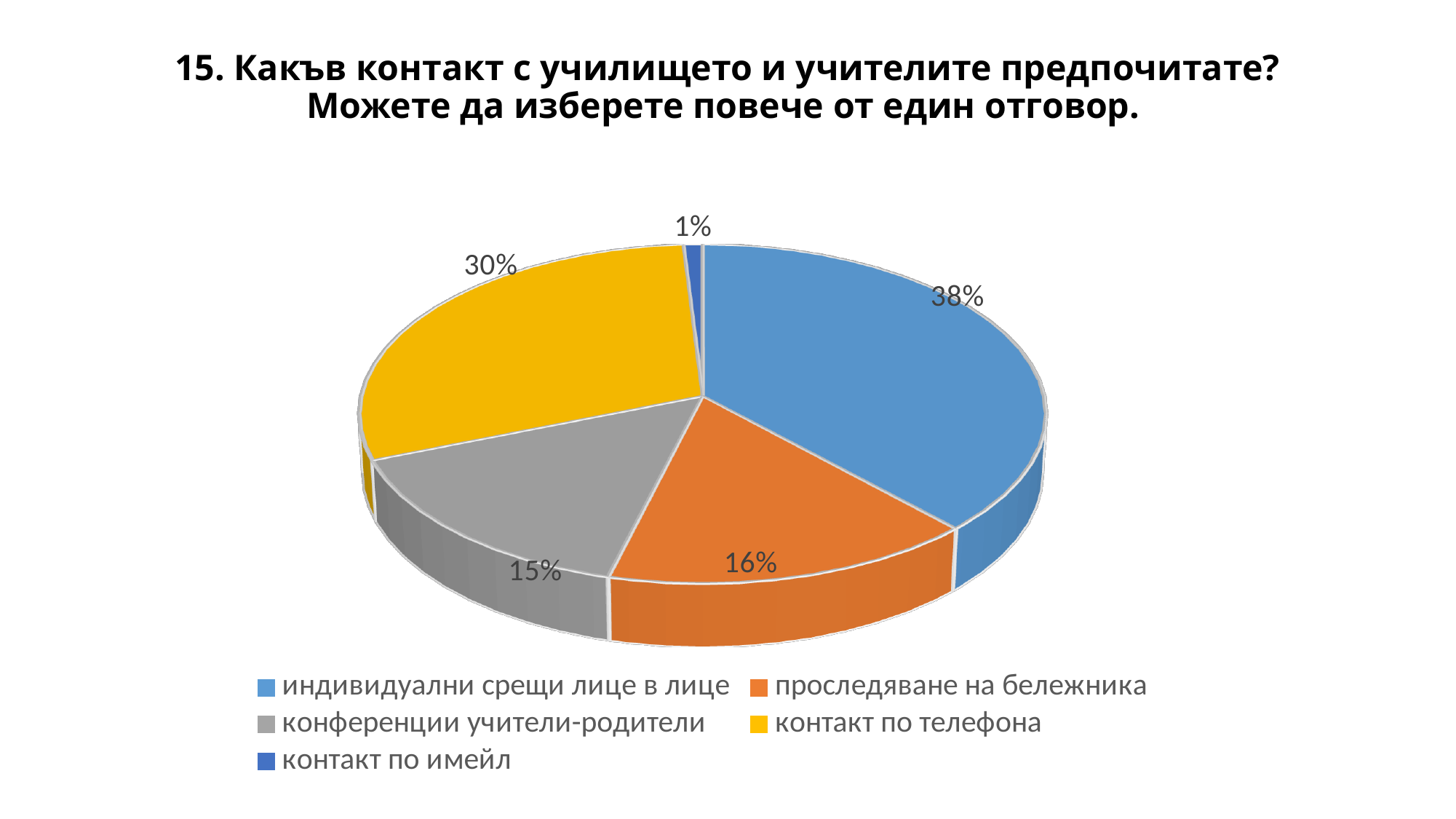
What kind of chart is shown on the slide? pie chart Which category has the smallest slice? контакт по имейл What share of the pie does "контакт по телефона" have? 30% How many categories does the pie chart show? 5 What is the value for "контакт по имейл"? 1% Which category has the largest slice? индивидуални срещи лице в лице Which is larger: the share for "контакт по телефона" or for "проследяване на бележника"? контакт по телефона What is the difference between the shares for "индивидуални срещи лице в лице" and "контакт по телефона"? 8% Which colour represents "контакт по телефона" in the legend? yellow What share of the pie does "индивидуални срещи лице в лице" have? 38% What is the value for "конференции учители-родители"? 15% What is the value for "проследяване на бележника"? 16%